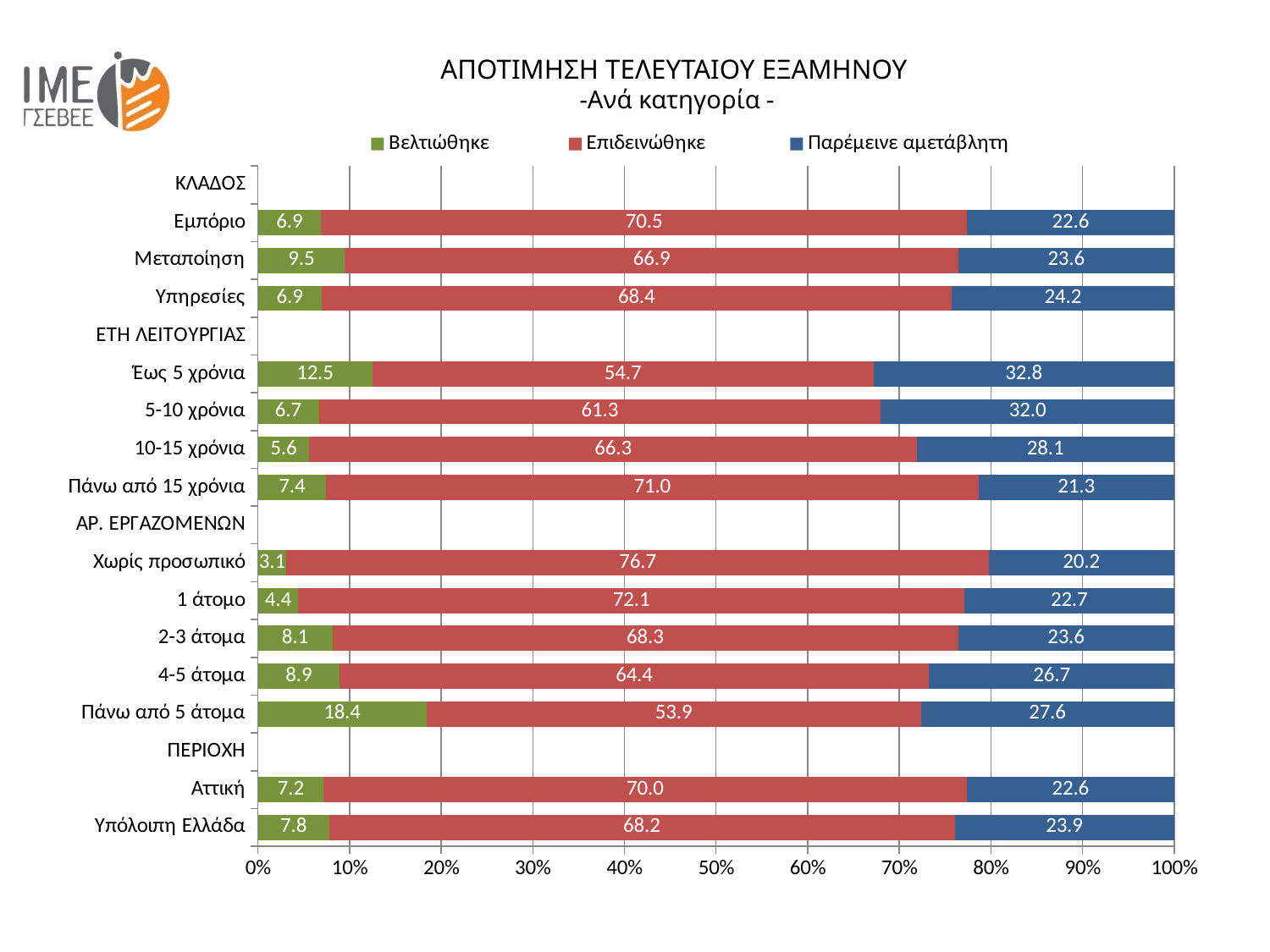
What colour represents Επιδεινώθηκε in the chart? Red Which has the larger Βελτιώθηκε value, Αττική or Υπόλοιπη Ελλάδα? Υπόλοιπη Ελλάδα Which category has the highest Επιδεινώθηκε value? Χωρίς προσωπικό What is the value of Επιδεινώθηκε for Εμπόριο? 70.5 What is the difference between the Βελτιώθηκε values for Μεταποίηση and Εμπόριο? 2.6 What is the value of Παρέμεινε αμετάβλητη for Έως 5 χρόνια? 32.8 What kind of chart is shown on the slide? Stacked bar chart Which category has the highest Βελτιώθηκε value? Πάνω από 5 άτομα What is the difference between the Επιδεινώθηκε values for Πάνω από 15 χρόνια and Έως 5 χρόνια? 16.3 Which category has the lowest Βελτιώθηκε value? Χωρίς προσωπικό How many series does the legend list? 3 What is the value of Βελτιώθηκε for Πάνω από 5 άτομα? 18.4